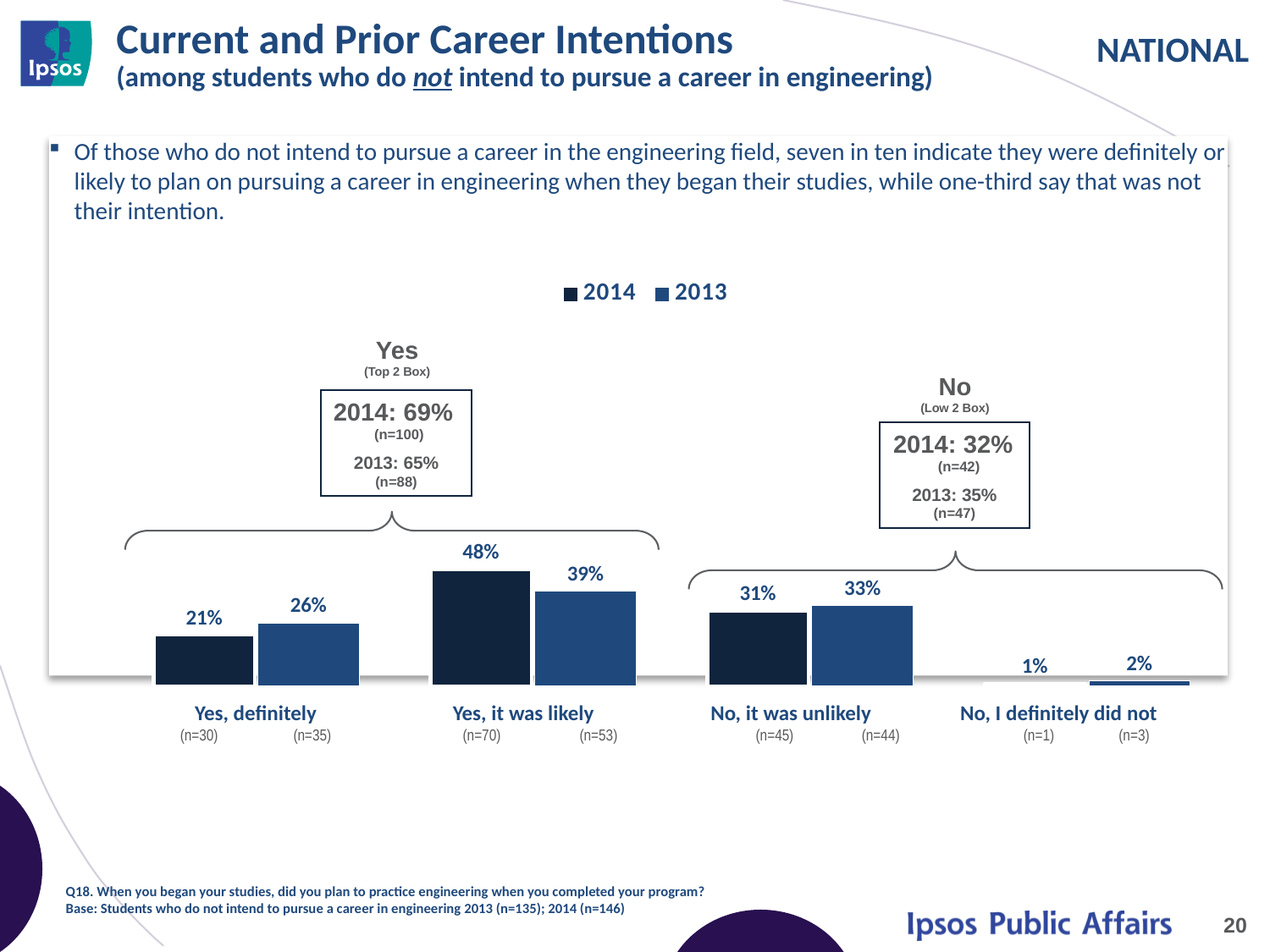
What kind of chart is shown on the slide? Bar chart What is the difference between the 2014 and 2013 values for "Yes, it was likely"? 9% How many categories are shown on the x axis? 4 What is the 2014 "Yes (Top 2 Box)" value shown in the callout box? 69% Which is larger for "Yes, definitely": the 2014 value or the 2013 value? 2013 What is the 2014 value for "Yes, it was likely"? 48% Which category has the highest 2014 value? Yes, it was likely How many series does the legend list? 2 What is the 2014 value for "No, I definitely did not"? 1% What is the 2013 value for "No, it was unlikely"? 33% Which category has the lowest 2013 value? No, I definitely did not What is the 2013 value for "Yes, definitely"? 26%